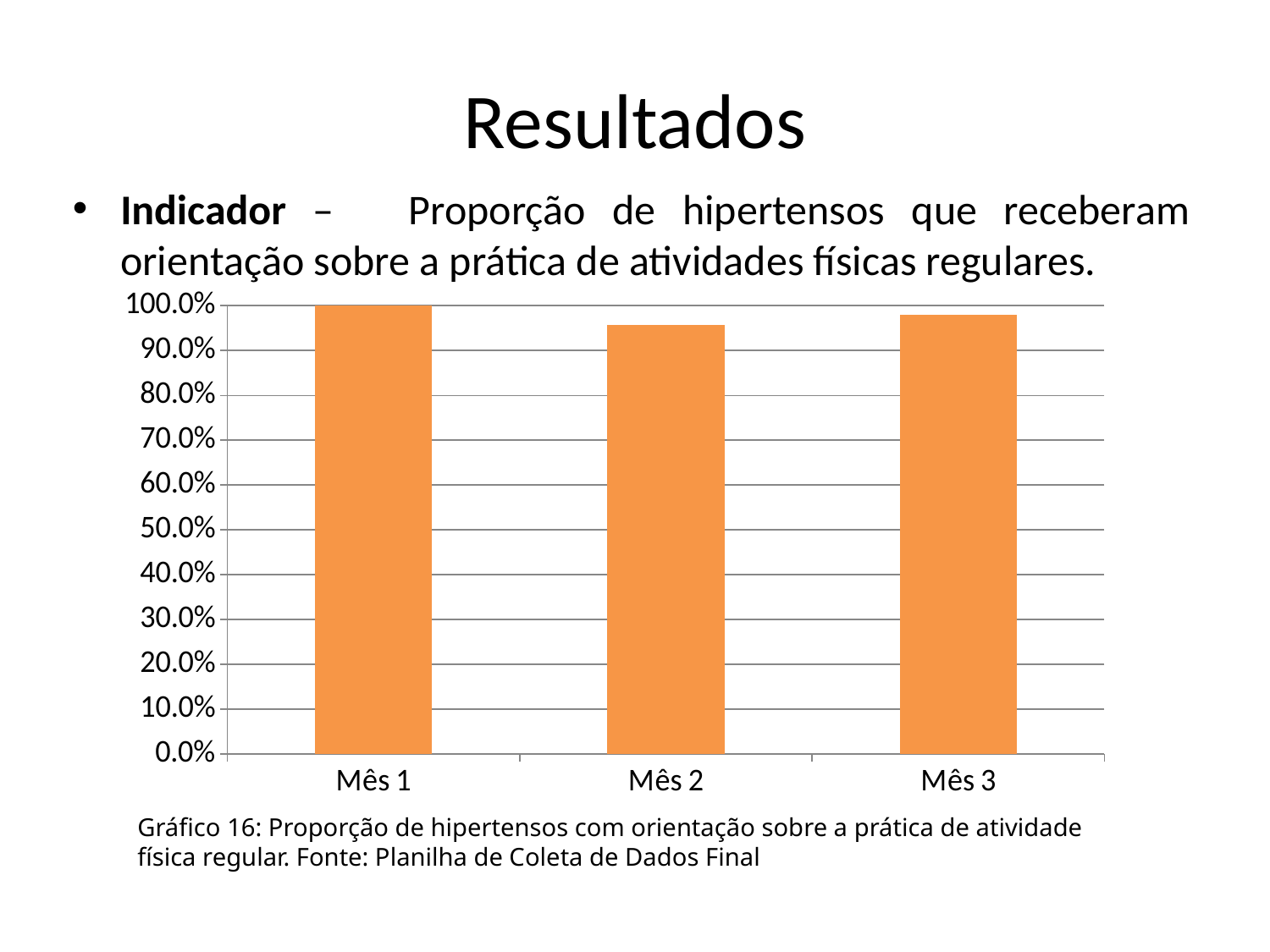
Does the value rise or fall from Mês 1 to Mês 2? Fall Is the value for Mês 2 greater or less than 90.0%? greater Which month has the highest value? Mês 1 What is the value for Mês 1? 100.0% Which month has the lowest value? Mês 2 Which is larger, the value for Mês 2 or the value for Mês 3? Mês 3 What colour are the bars in the chart? Orange What kind of chart is shown on the slide? Bar chart How many months are shown on the x axis? 3 What is the number of the chart given in the caption below it? Gráfico 16 Is the value for Mês 2 greater or less than 100.0%? less Is the value for Mês 3 greater or less than 100.0%? less